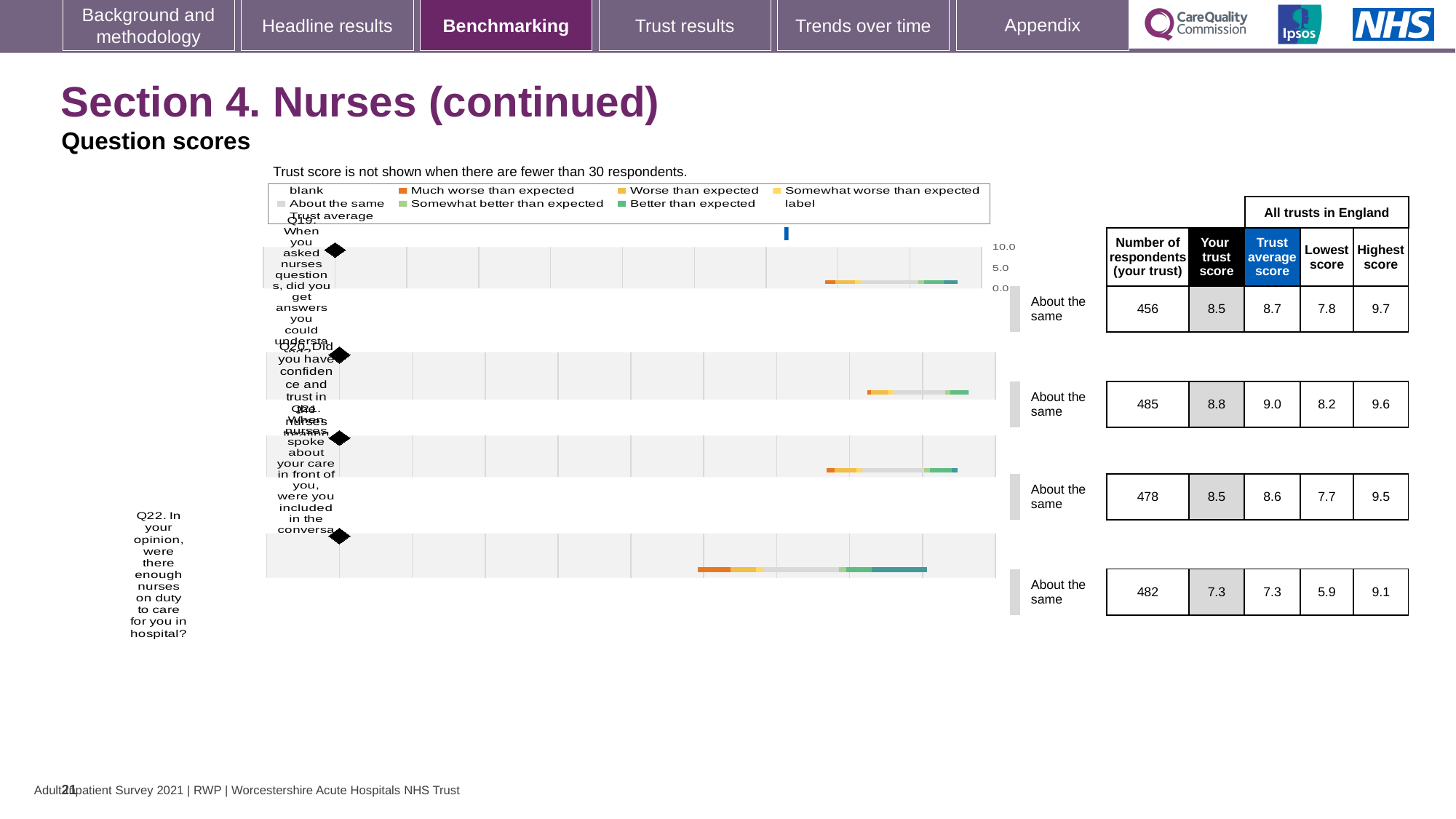
Which question has the lowest trust score on this slide? Q22 What is the trust average score for Q20? 9.0 What kind of chart is used to show the question scores? Bar chart How many respondents answered Q20 (did you have confidence and trust in the nurses treating you)? 485 For Q22, what is the difference between the highest score and the lowest score across all trusts in England? 3.2 What is the trust score for Q22 (were there enough nurses on duty to care for you in hospital)? 7.3 What benchmark category label is shown next to each of the four questions? About the same Which has the higher trust average score, Q19 or Q21? Q19 For Q19, what is the difference between the highest score and the lowest score across all trusts in England? 1.9 What is the lowest score across all trusts in England for Q21? 7.7 Which question has the highest trust score on this slide? Q20 How many questions are plotted on this slide? 4